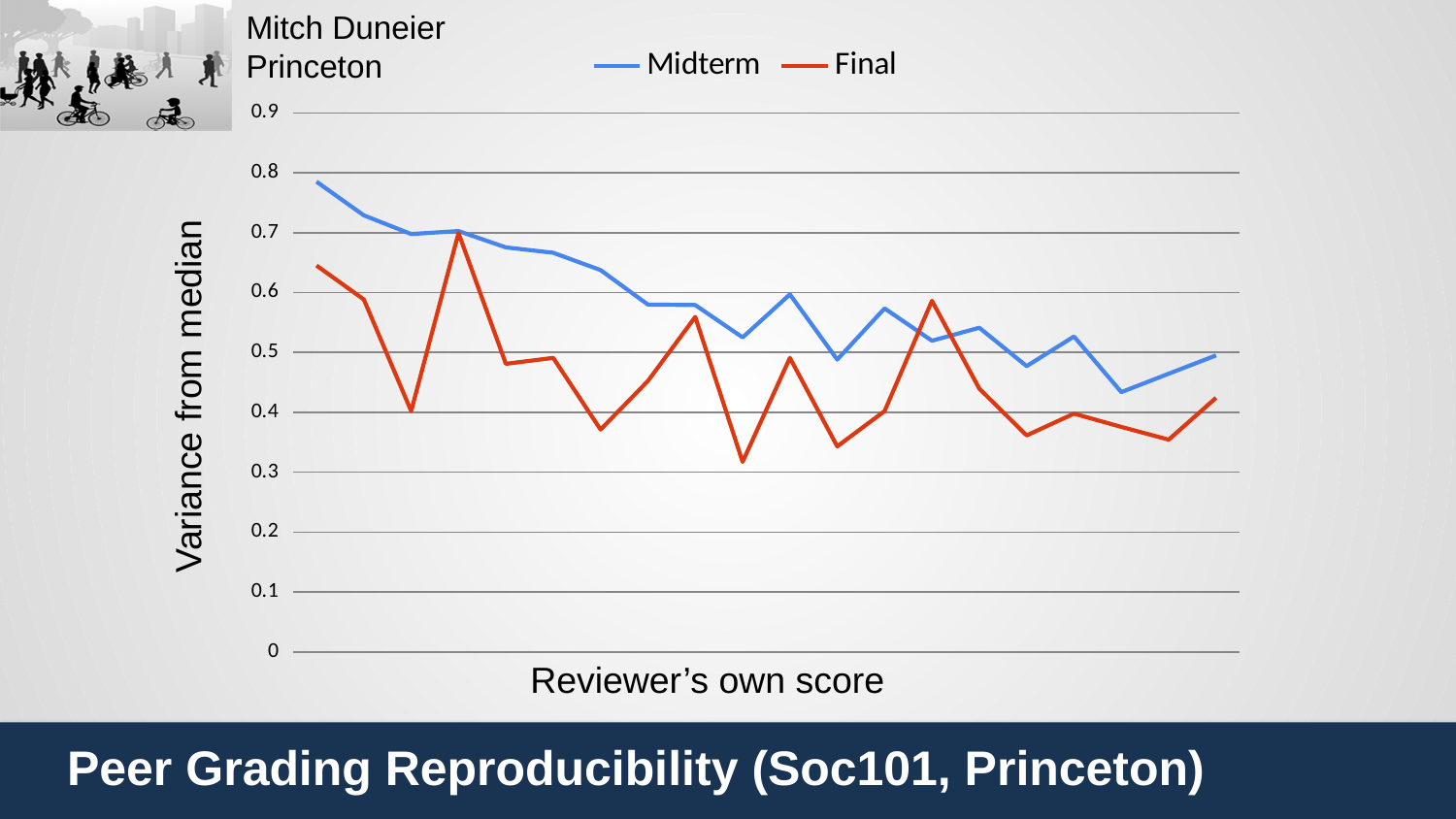
How many series does the legend list? 2 Is the leftmost value of the Final series greater or less than 0.6? greater What are the two series named in the legend? Midterm and Final What is the label on the vertical axis? Variance from median Is the lowest value of the Final series greater or less than 0.4? less Is the leftmost value of the Midterm series greater or less than 0.7? greater Which series is drawn in red? Final Does the Midterm line generally rise or fall from left to right? Fall Which series has the higher value at the leftmost point, Midterm or Final? Midterm Which series reaches the highest value on the chart? Midterm What kind of chart is shown on the slide? Line chart